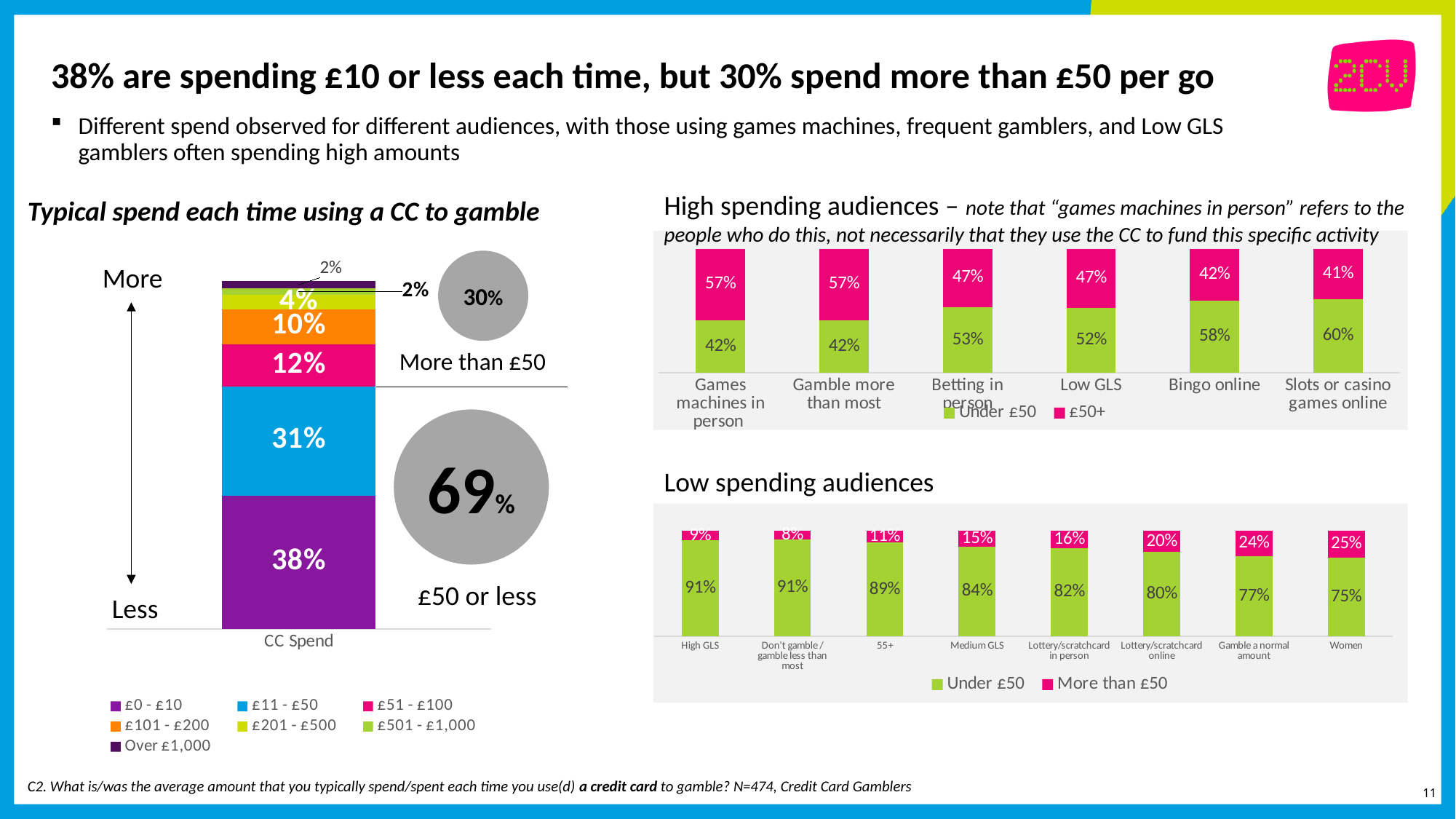
In the 'Low spending audiences' chart, which category has the lowest More than £50 value? Don't gamble / gamble less than most In the 'Typical spend each time using a CC to gamble' chart, what percentage is shown for the £0 - £10 segment? 38% In the 'High spending audiences' chart, which is larger for Betting in person: Under £50 or £50+? Under £50 In the 'Typical spend each time using a CC to gamble' chart, what percentage is shown for the £11 - £50 segment? 31% In the 'High spending audiences' chart, which category has the highest Under £50 value? Slots or casino games online How many categories are shown in the 'Low spending audiences' chart? 8 In the 'Typical spend each time using a CC to gamble' chart, what is the difference between the £0 - £10 segment and the £51 - £100 segment? 26% How many series does the legend of the 'Typical spend each time using a CC to gamble' chart list? 7 In the 'High spending audiences' chart, what is the £50+ value for Bingo online? 42% What type of chart is the 'Low spending audiences' chart? Stacked bar chart How many categories are shown in the 'High spending audiences' chart? 6 In the 'Low spending audiences' chart, what is the Under £50 value for Women? 75%